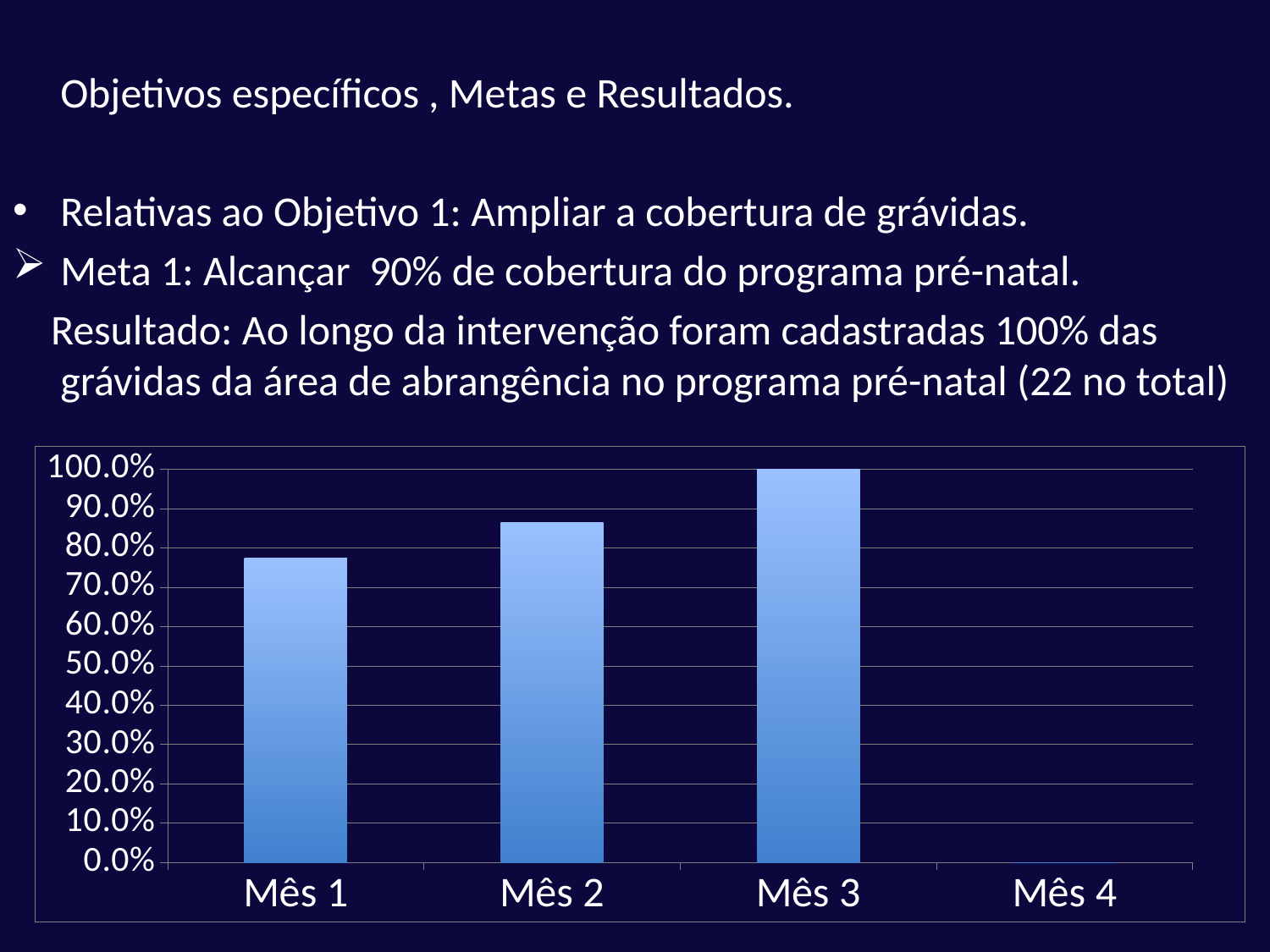
Do the values rise or fall from Mês 1 to Mês 3? rise Which month has the highest bar? Mês 3 What kind of chart is shown on the slide? bar chart Is the value for Mês 2 greater or less than 80.0%? greater What is the highest value shown on the y axis? 100.0% Which is larger, the value for Mês 1 or the value for Mês 2? Mês 2 Is the value for Mês 2 greater or less than 90.0%? less How many category labels are shown on the x axis? 4 Is the value for Mês 1 greater or less than 80.0%? less What is the value for Mês 3? 100.0% Of the bars plotted for Mês 1, Mês 2 and Mês 3, which is the lowest? Mês 1